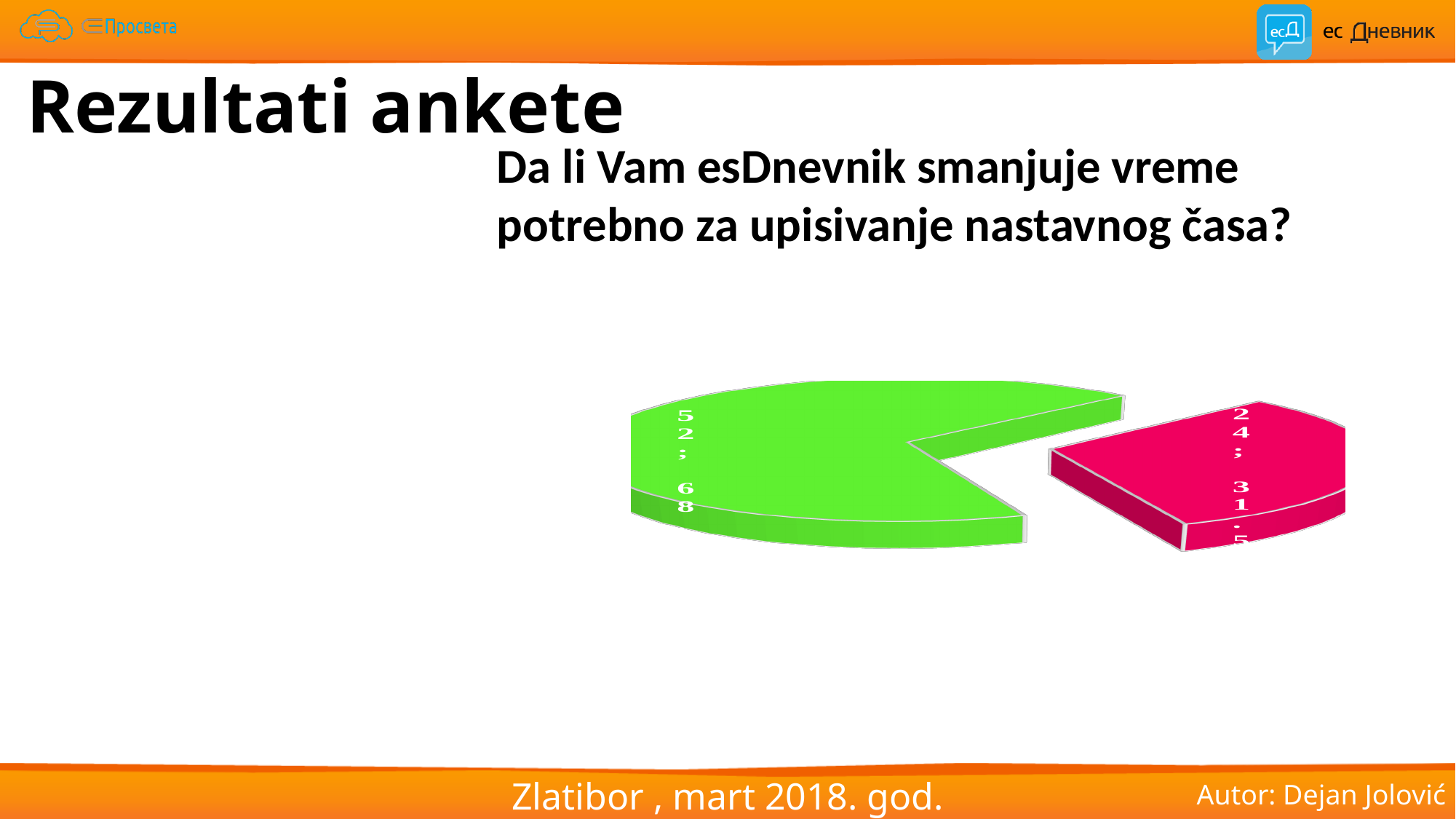
What is the value shown on the red slice of the pie chart? 24 What colours are the two slices of the pie chart? green and red Which slice of the pie chart is the smallest? the red slice Which slice of the pie chart is the largest? the green slice How many slices does the pie chart have? 2 What is the title of the chart on the slide? Da li Vam esDnevnik smanjuje vreme potrebno za upisivanje nastavnog časa? What is the value shown on the green slice of the pie chart? 52 What kind of chart is shown on the slide? pie chart What is the difference between the value of the green slice and the value of the red slice? 28 Which slice has the larger value, the green slice or the red slice? the green slice